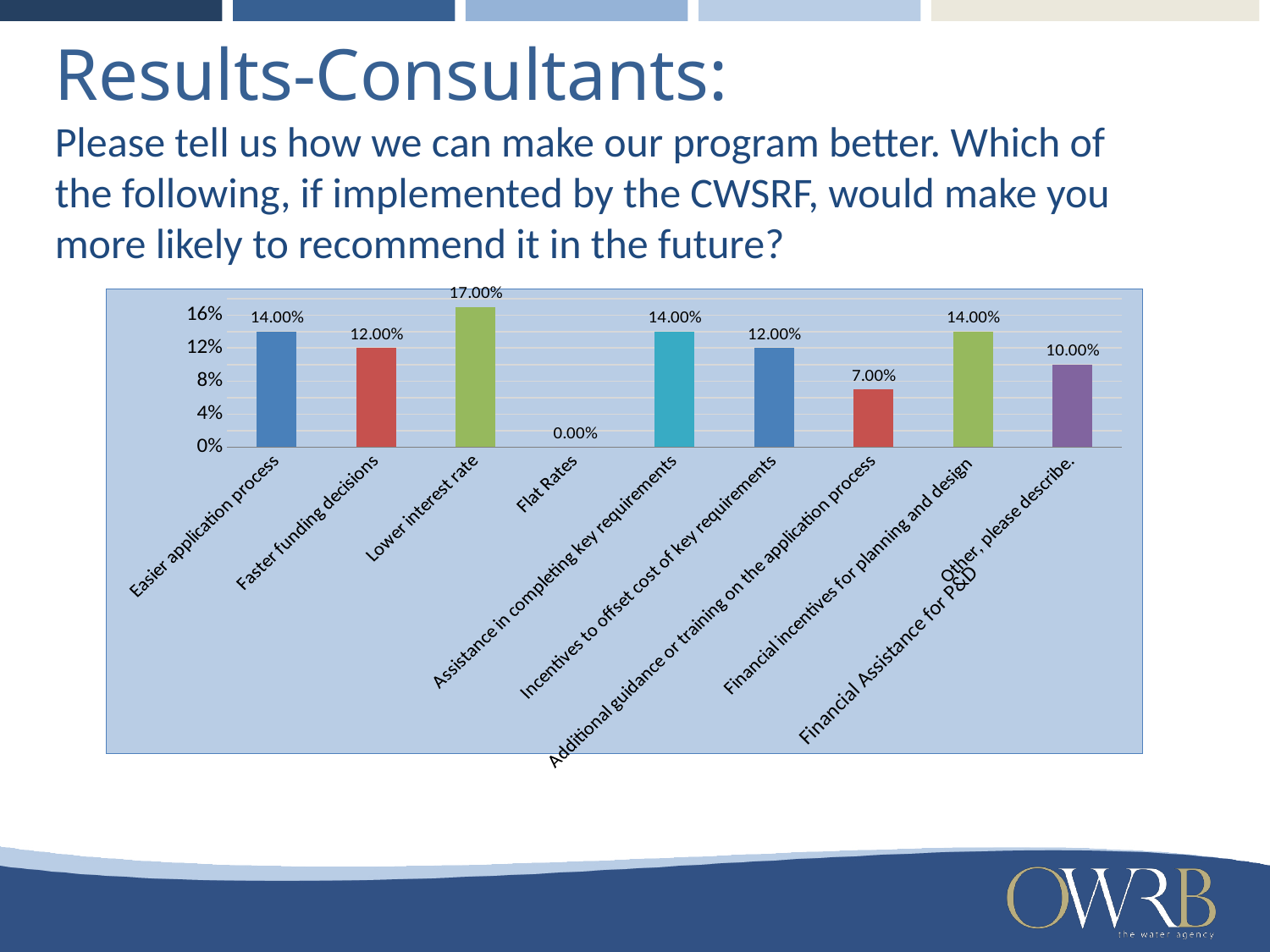
What is the difference between the values for Lower interest rate and Faster funding decisions? 5.00% What is the value for Lower interest rate? 17.00% Which category has the highest value? Lower interest rate Which category has the lowest value? Flat Rates What kind of chart is shown on the slide? bar chart What is the value for Flat Rates? 0.00% Is the value for Financial incentives for planning and design greater or less than 12%? greater Which is larger, the value for Easier application process or the value for Additional guidance or training on the application process? Easier application process What is the value for Additional guidance or training on the application process? 7.00% What is the value for Incentives to offset cost of key requirements? 12.00% How many categories are shown on the x axis? 9 What is the value for Other, please describe.? 10.00%